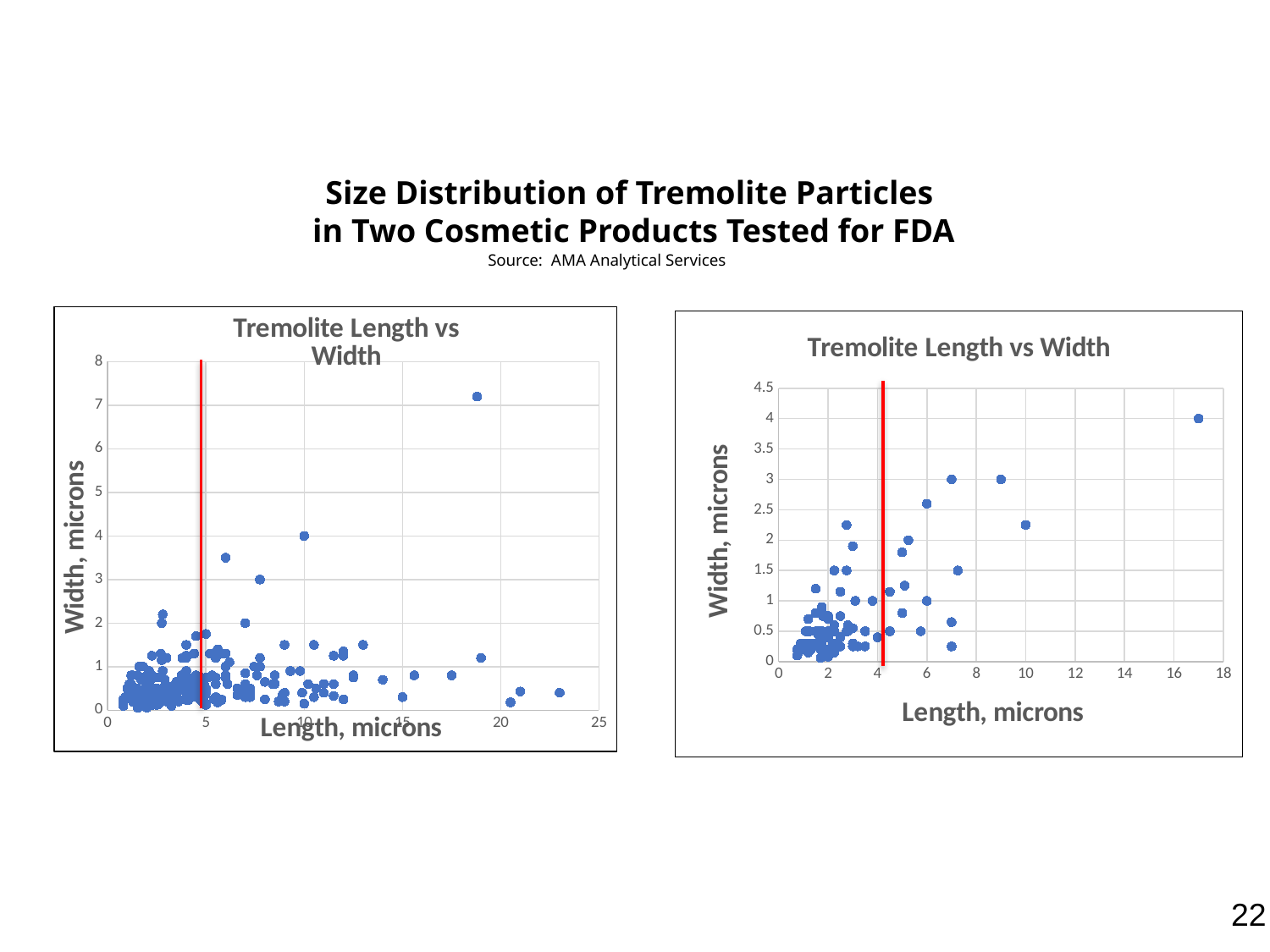
On the right chart, is the length marked by the red vertical line greater or less than 6 microns? less What kind of chart is the left chart titled 'Tremolite Length vs Width'? scatter chart On the right chart, what is the label of the horizontal axis? Length, microns On the right chart, is the width of the highest plotted point greater or less than 3.5 microns? greater On the left chart, is the length of the point farthest to the right greater or less than 20 microns? greater What kind of chart is the right chart titled 'Tremolite Length vs Width'? scatter chart On the left chart, what is the label of the vertical axis? Width, microns Which chart has the plotted point with the larger width, the left chart or the right chart? the left chart